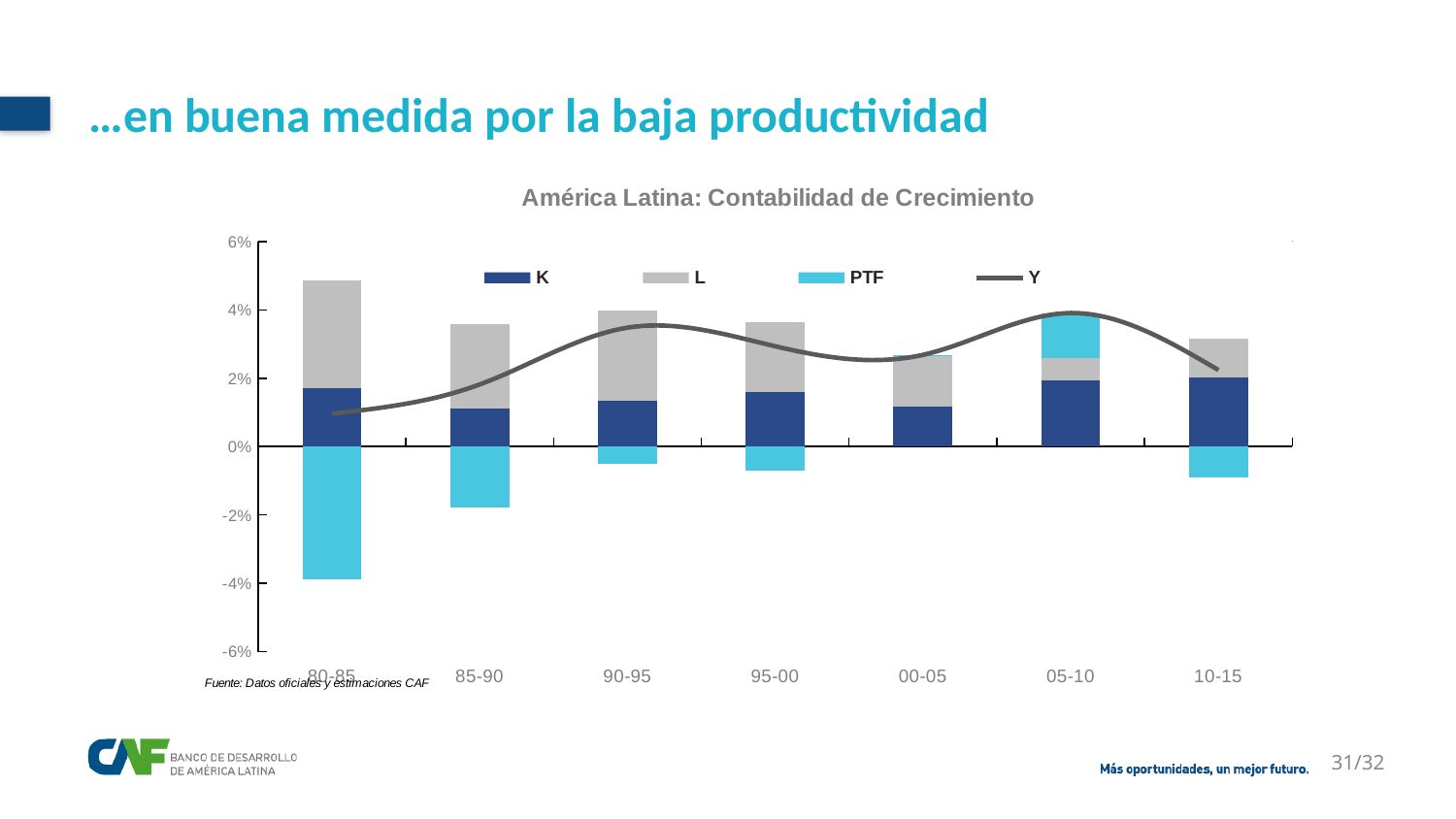
How many periods are shown on the x axis? 7 What kind of chart is shown on the slide? Bar chart (stacked bars with a line) Is the Y value for 90-95 greater or less than 2%? greater Does the Y line rise or fall from 80-85 to 90-95? rise Is the PTF value for 80-85 greater or less than -2%? less In which period does the Y line reach its highest point? 05-10 Which is larger, the L value for 80-85 or the L value for 05-10? 80-85 Is the Y value for 80-85 greater or less than 2%? less What is the title of the chart? América Latina: Contabilidad de Crecimiento How many series does the legend list? 4 Which period has the lowest PTF value? 80-85